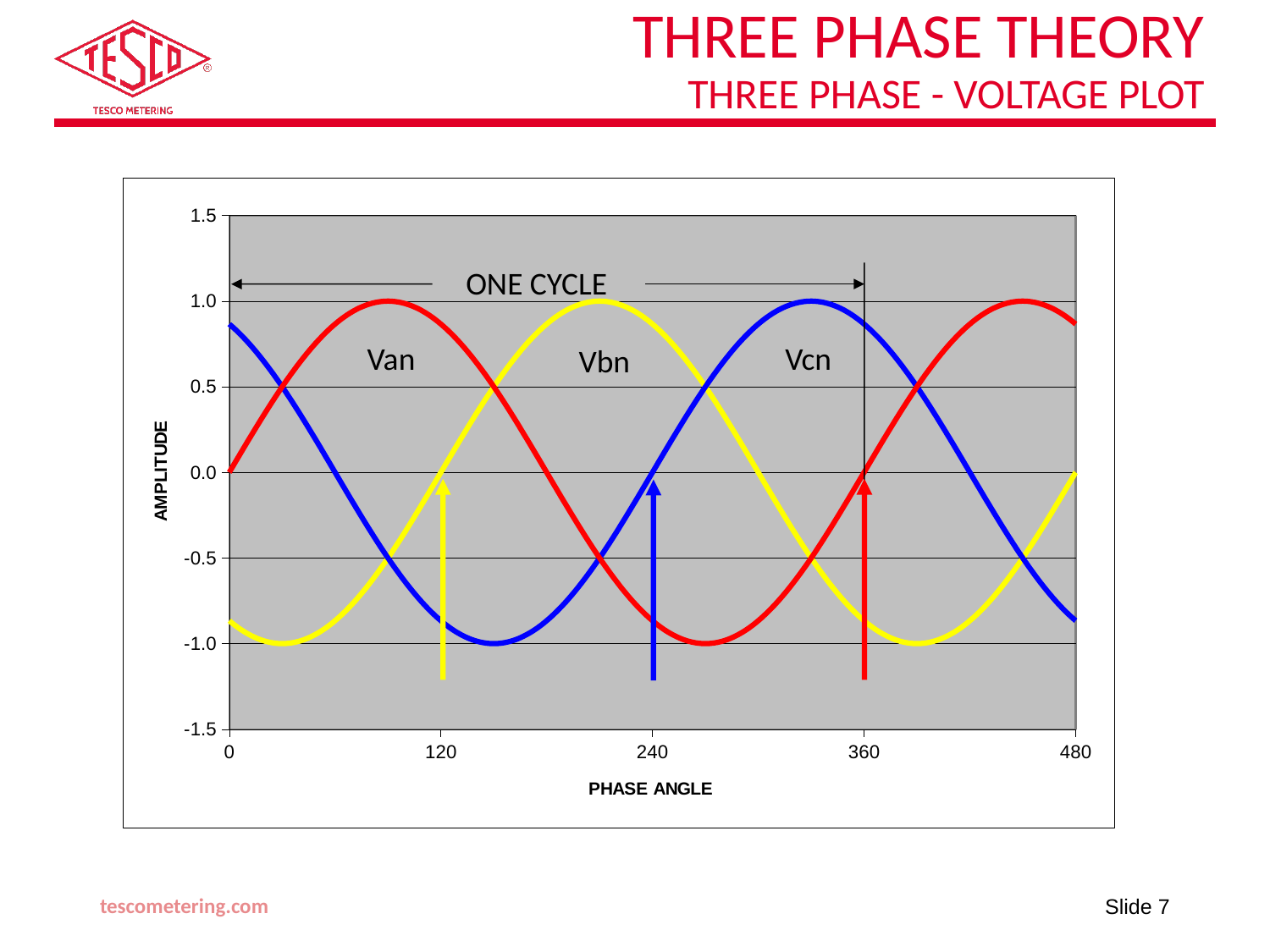
Does the amplitude of Van rise or fall between phase angles 120 and 240? fall Is the amplitude of Van at a phase angle of 120 greater or less than 0.5? greater What is the amplitude of Van at a phase angle of 0? 0.0 What is the label of the y axis? AMPLITUDE At a phase angle of 0, which has the larger amplitude, Vcn or Vbn? Vcn Is the amplitude of Vcn at a phase angle of 120 greater or less than -0.5? less What kind of chart is shown on the slide? line chart What is the amplitude of Van at a phase angle of 360? 0.0 What is the label of the x axis? PHASE ANGLE What is the amplitude of Vcn at a phase angle of 240? 0.0 What is the amplitude of Vbn at a phase angle of 120? 0.0 How many voltage waveforms are plotted on the chart? 3